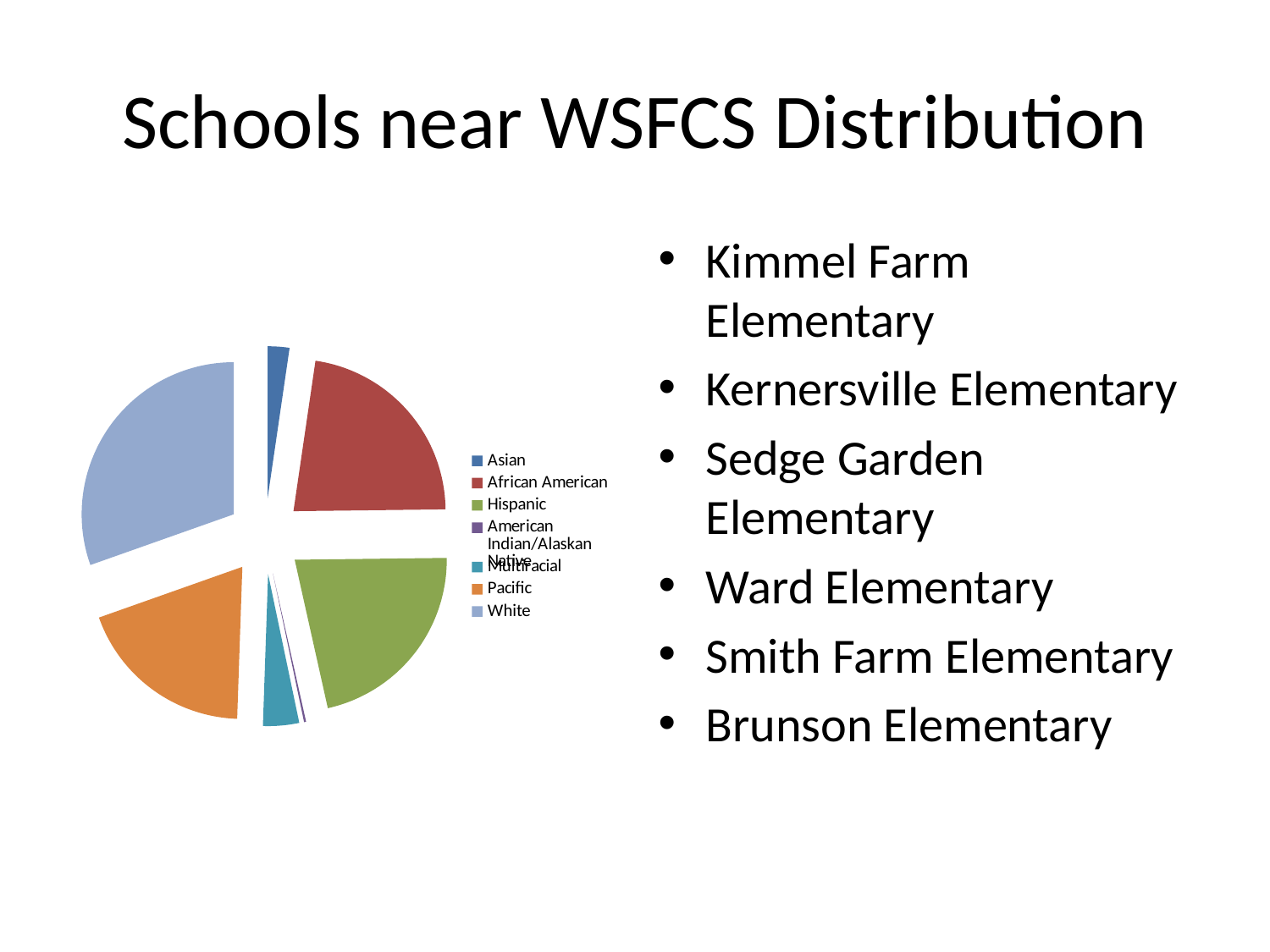
Which slice is larger, Pacific or Asian? Pacific What colour is the Pacific slice in the pie chart? orange How many categories does the pie chart's legend list? 7 Which slice is larger, Asian or American Indian/Alaskan Native? Asian What kind of chart is shown on the slide? pie chart Which slice is larger, Hispanic or Multiracial? Hispanic Which category is listed first in the pie chart's legend? Asian Which category has the smallest slice of the pie chart? American Indian/Alaskan Native Which category has the largest slice of the pie chart? White